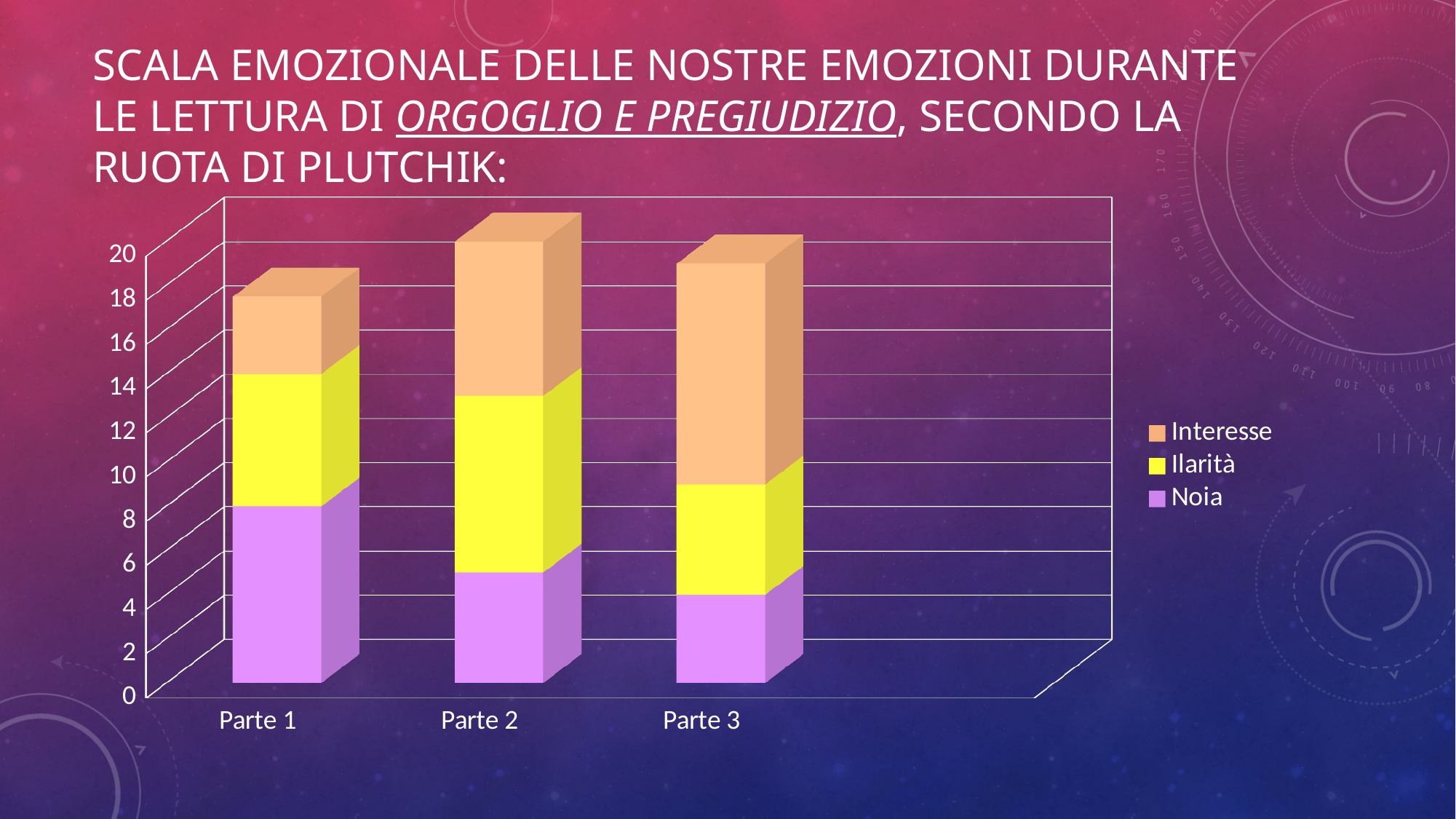
Is the value of Ilarità for Parte 2 greater or less than 6? greater Which category has the highest value for Interesse? Parte 3 Which category has the highest value for Noia? Parte 1 Is the value of Noia for Parte 3 greater or less than 6? less Does the value of Noia rise or fall from Parte 1 to Parte 3? fall How many categories are shown on the x axis of the chart? 3 How many series does the chart legend list? 3 What kind of chart is shown on the slide? stacked bar chart Is the value of Interesse for Parte 3 greater or less than 6? greater Which series are listed in the chart legend? Interesse, Ilarità, Noia Which colour represents Noia in the chart? purple